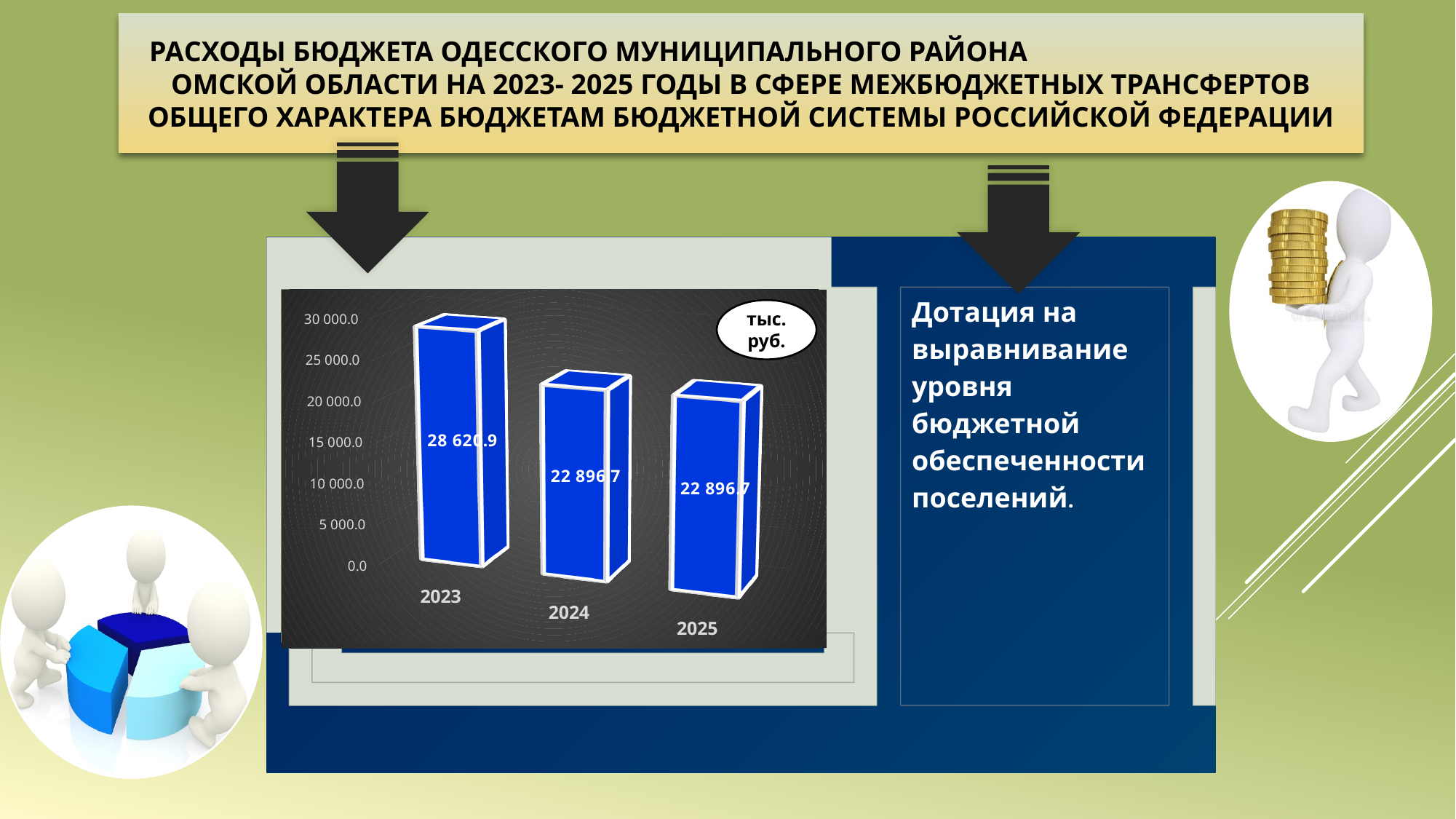
Which year has the highest value? 2023 What is the value for 2025? 22 896.7 What is the value for 2024? 22 896.7 Are the values for 2024 and 2025 equal? Yes What is the difference between the values for 2023 and 2024? 5 724.2 Is the value for 2023 greater or less than 25 000.0? greater In what units are the chart values given, according to the label on the chart? тыс. руб. Which is larger, the value for 2023 or the value for 2025? 2023 What is the value for 2023? 28 620.9 Is the value for 2024 greater or less than 25 000.0? less How many years are shown on the chart? 3 What kind of chart is shown on the slide? Bar chart